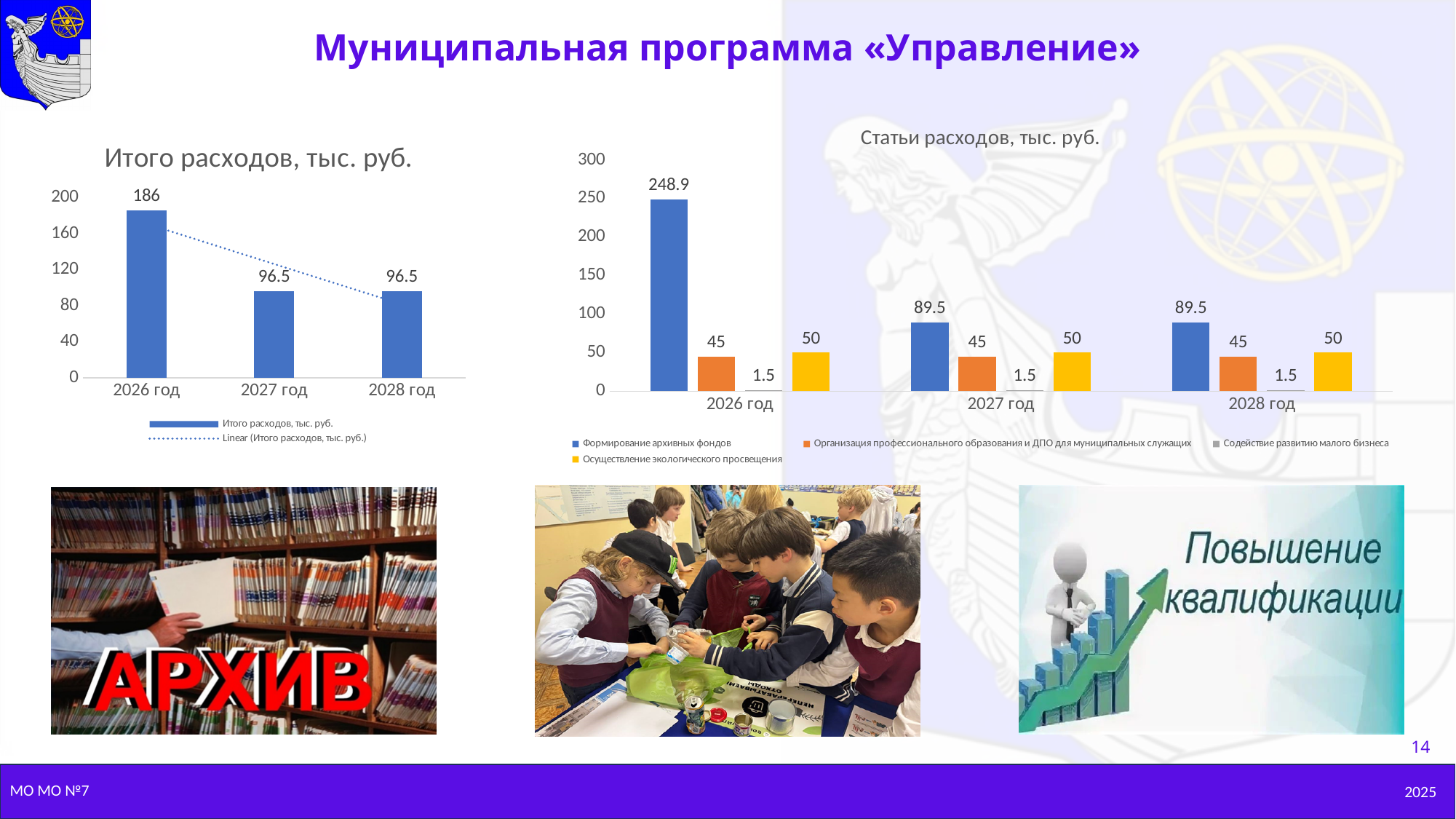
In the chart 'Статьи расходов, тыс. руб.', what is the value for Формирование архивных фондов in 2026 год? 248.9 In the chart 'Итого расходов, тыс. руб.', how many years are shown on the x axis? 3 In the chart 'Статьи расходов, тыс. руб.', which is larger in 2027 год: Формирование архивных фондов or Организация профессионального образования и ДПО для муниципальных служащих? Формирование архивных фондов In the chart 'Итого расходов, тыс. руб.', what is the value for 2026 год? 186 In the chart 'Статьи расходов, тыс. руб.', what is the value for Осуществление экологического просвещения in 2027 год? 50 In the chart 'Статьи расходов, тыс. руб.', how many series does the legend list? 4 In the chart 'Статьи расходов, тыс. руб.', what is the value for Содействие развитию малого бизнеса in 2028 год? 1.5 In the chart 'Итого расходов, тыс. руб.', which year has the highest value? 2026 год In the chart 'Итого расходов, тыс. руб.', what is the difference between the values for 2026 год and 2028 год? 89.5 In the chart 'Итого расходов, тыс. руб.', do the values rise or fall from 2026 год to 2028 год? fall What kind of chart is 'Статьи расходов, тыс. руб.'? bar chart In the chart 'Итого расходов, тыс. руб.', what is the value for 2027 год? 96.5